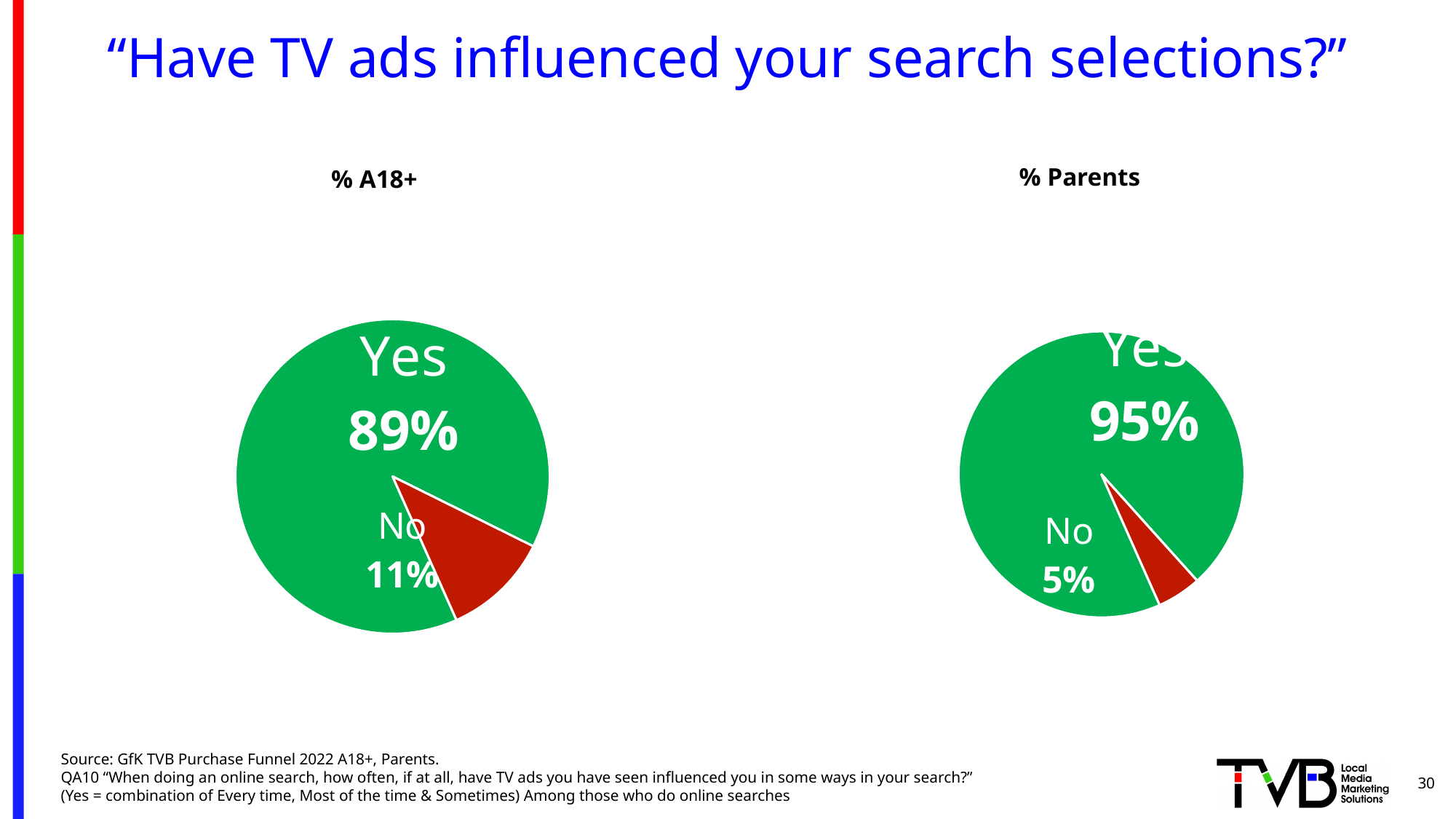
In the "% Parents" pie chart, what percentage answered Yes? 95% In the "% A18+" pie chart, what colour is the No slice? Red How many slices does the "% Parents" pie chart have? 2 In the "% A18+" pie chart, what percentage answered No? 11% What type of chart is used for the "% A18+" data? Pie chart In the "% A18+" pie chart, which response has the smallest share? No In the "% Parents" pie chart, which response has the largest share? Yes What is the difference between the Yes share in the "% Parents" chart and the Yes share in the "% A18+" chart? 6 percentage points What is the difference between the Yes and No shares in the "% A18+" pie chart? 78 percentage points In the "% A18+" pie chart, what percentage answered Yes? 89% In the "% Parents" pie chart, what percentage answered No? 5% Which chart shows a larger No share, "% A18+" or "% Parents"? % A18+